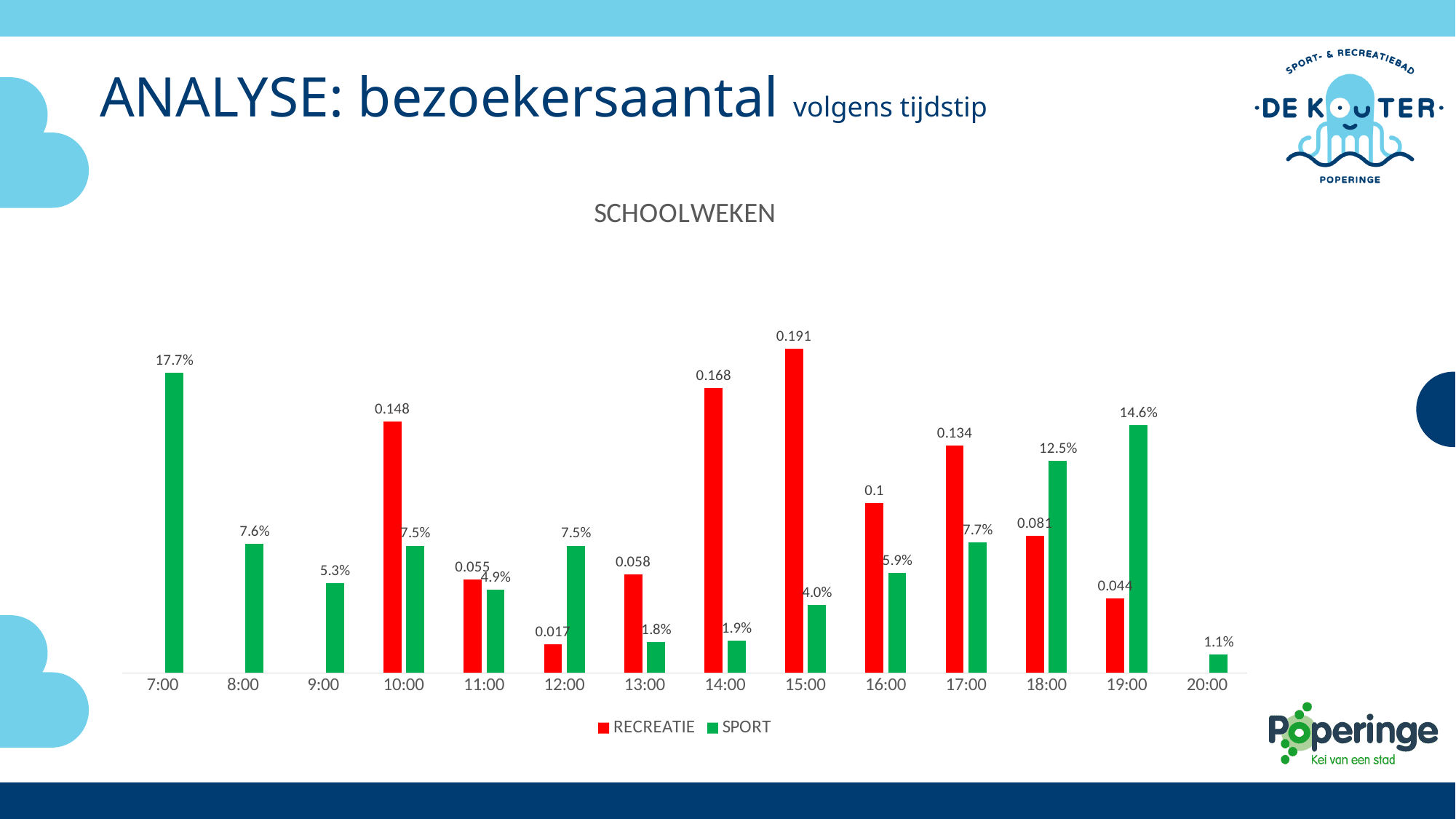
How many series does the legend list? 2 How many time categories are shown on the x axis? 14 What is the value of the SPORT series at 7:00? 17.7% What is the value of the SPORT series at 18:00? 12.5% Which is larger: the SPORT value at 8:00 or at 17:00? 17:00 At which time is the RECREATIE value highest? 15:00 What is the value of the RECREATIE series at 12:00? 0.017 What kind of chart is shown on the slide? Bar chart What is the difference between the SPORT values at 19:00 and 18:00? 2.1% What is the value of the RECREATIE series at 15:00? 0.191 At which time is the SPORT value lowest? 20:00 What is the difference between the RECREATIE values at 14:00 and 10:00? 0.02